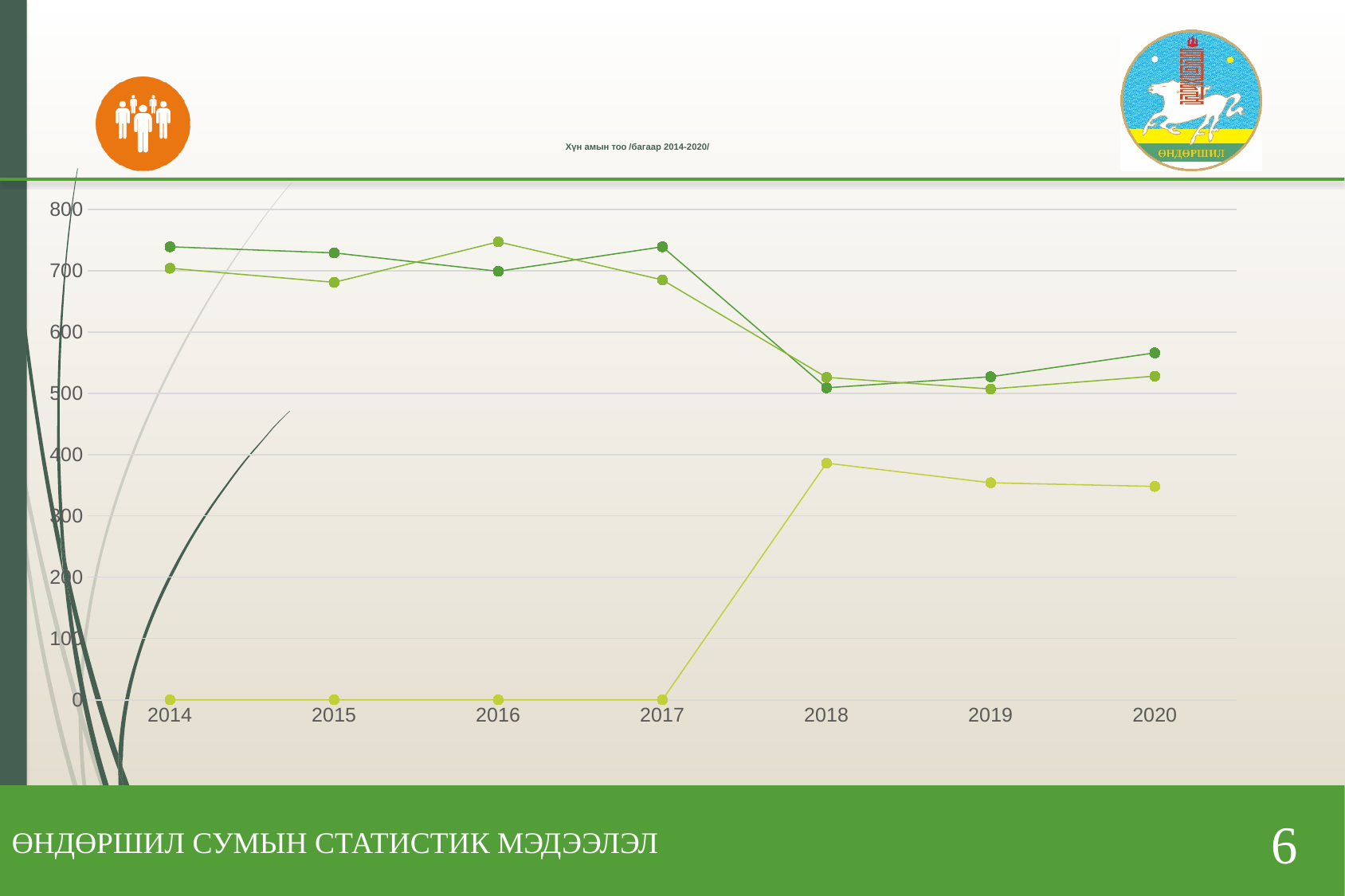
Is the value of the dark green series in 2014 greater or less than 700? greater Is the value of the dark green series in 2020 greater or less than 500? greater Does the dark green series rise or fall between 2017 and 2018? fall What is the value of the light yellow-green series in 2014? 0 What kind of chart is shown on the slide? line chart What is the title of the chart? Хүн амын тоо /багаар 2014-2020/ How many years are shown on the x axis of the chart? 7 In which year does the medium green series reach its highest value? 2016 Is the value of the light yellow-green series in 2018 greater or less than 400? less In which year does the light yellow-green series reach its highest value? 2018